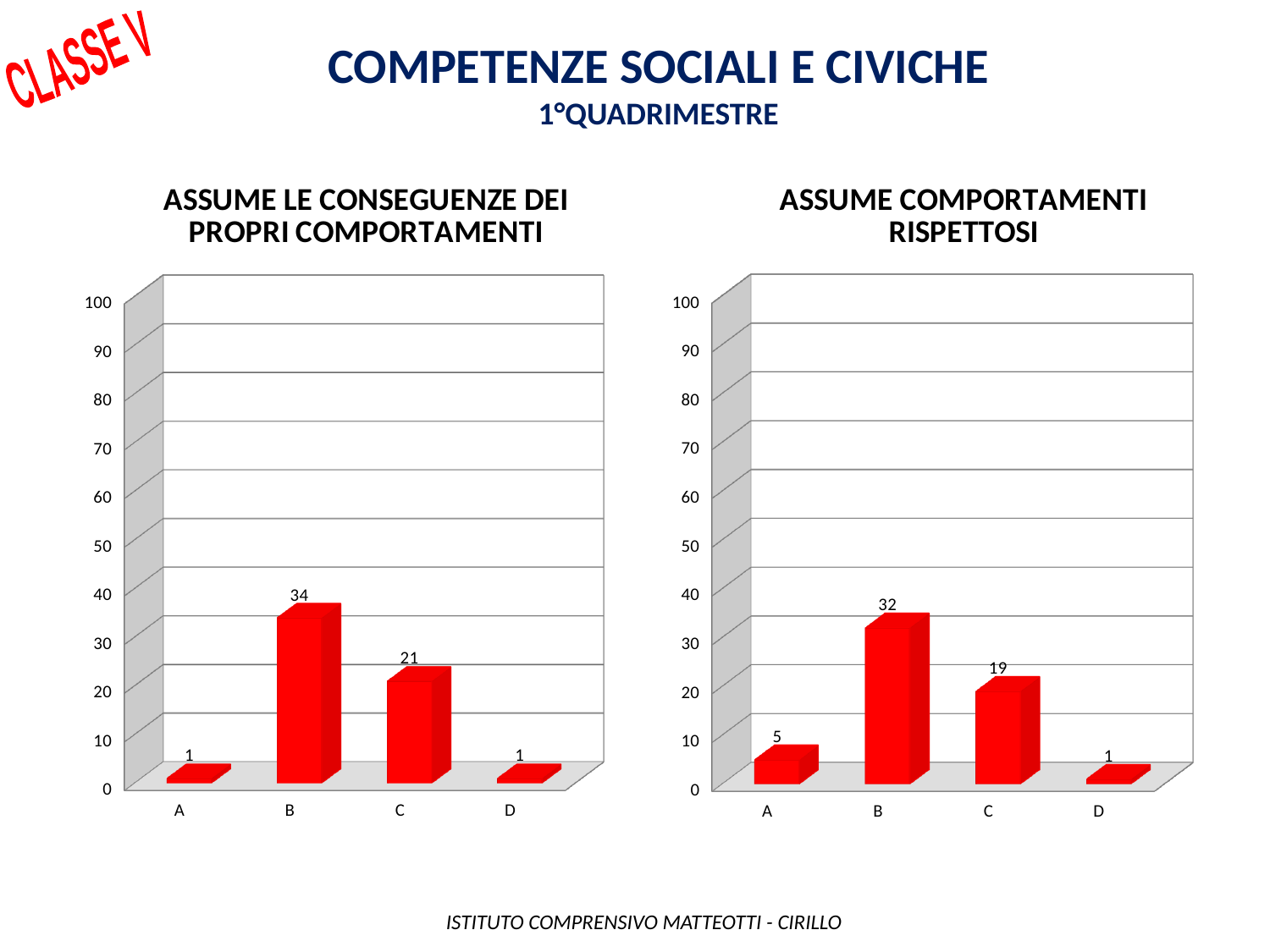
How many categories are shown on the x axis of the chart titled "ASSUME COMPORTAMENTI RISPETTOSI"? 4 In the chart titled "ASSUME COMPORTAMENTI RISPETTOSI", which category has the lowest value? D In the chart titled "ASSUME COMPORTAMENTI RISPETTOSI", what is the value for category C? 19 What kind of chart is the chart titled "ASSUME LE CONSEGUENZE DEI PROPRI COMPORTAMENTI"? Bar chart In the chart titled "ASSUME LE CONSEGUENZE DEI PROPRI COMPORTAMENTI", is the value for B greater or less than 30? greater In the chart titled "ASSUME COMPORTAMENTI RISPETTOSI", what is the difference between the values for B and A? 27 In the chart titled "ASSUME LE CONSEGUENZE DEI PROPRI COMPORTAMENTI", which category has the highest value? B In the chart titled "ASSUME LE CONSEGUENZE DEI PROPRI COMPORTAMENTI", what is the difference between the values for B and C? 13 In the chart titled "ASSUME LE CONSEGUENZE DEI PROPRI COMPORTAMENTI", what is the value for category B? 34 In the chart titled "ASSUME COMPORTAMENTI RISPETTOSI", what is the value for category A? 5 In the chart titled "ASSUME COMPORTAMENTI RISPETTOSI", which is larger, the value for A or the value for C? C What colour are the bars in the chart titled "ASSUME COMPORTAMENTI RISPETTOSI"? Red